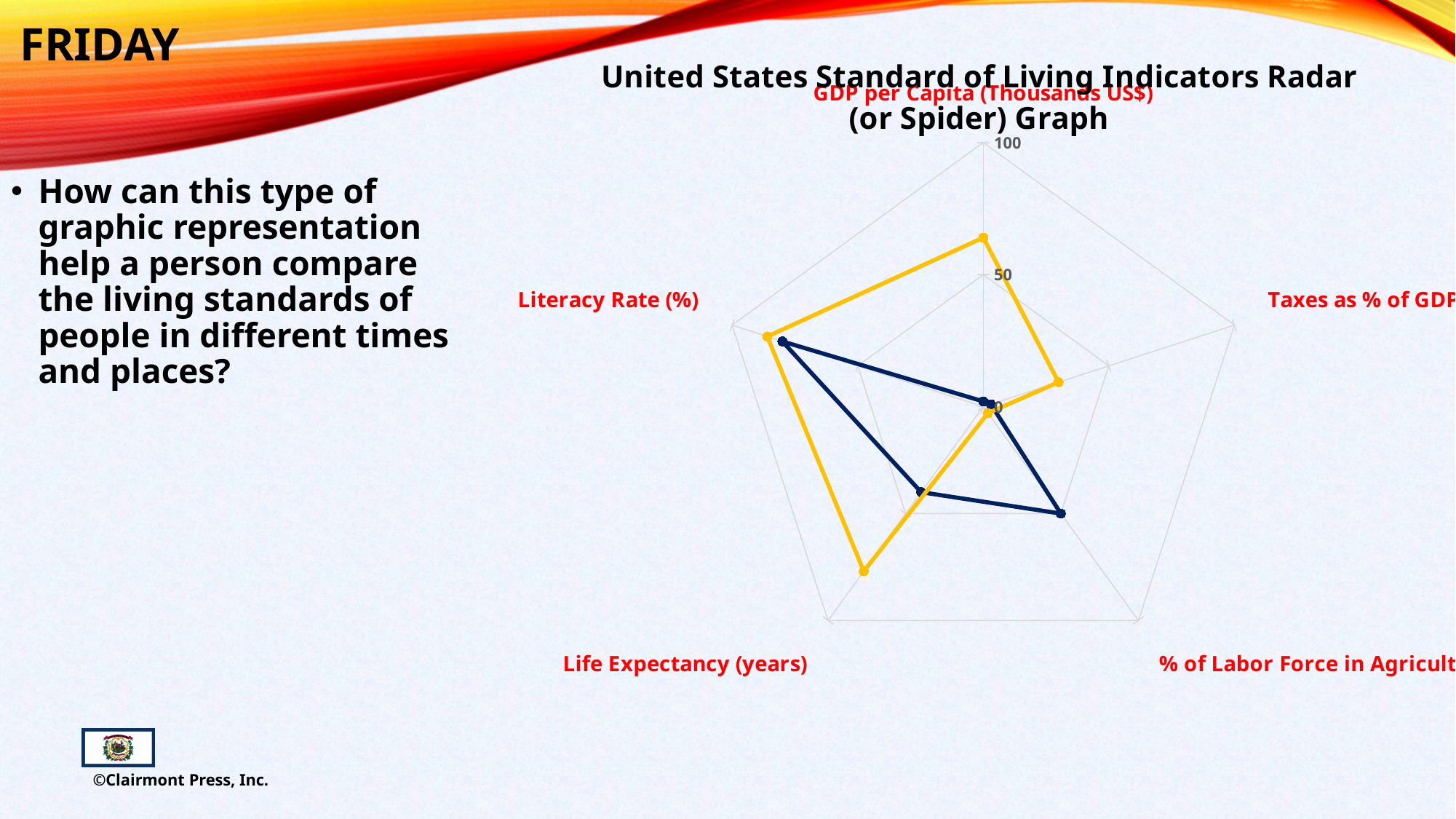
How many indicator axes (categories) does the radar chart have? 5 On which axis does the yellow line reach its highest value? Literacy Rate (%) What is the title of the chart? United States Standard of Living Indicators Radar (or Spider) Graph How many data series (lines) are plotted on the radar chart? 2 Which line has the higher value for GDP per Capita (Thousands US$), the yellow line or the dark blue line? Yellow line Is the yellow line's value for Taxes as % of GDP greater or less than 50? less What type of chart is shown on the slide? Radar (spider) chart What is the maximum value shown on the radar chart's scale? 100 Is the yellow line's value for GDP per Capita (Thousands US$) greater or less than 50? greater Is the dark blue line's value for Life Expectancy (years) greater or less than 50? less Which line has the higher value for Life Expectancy (years), the yellow line or the dark blue line? Yellow line